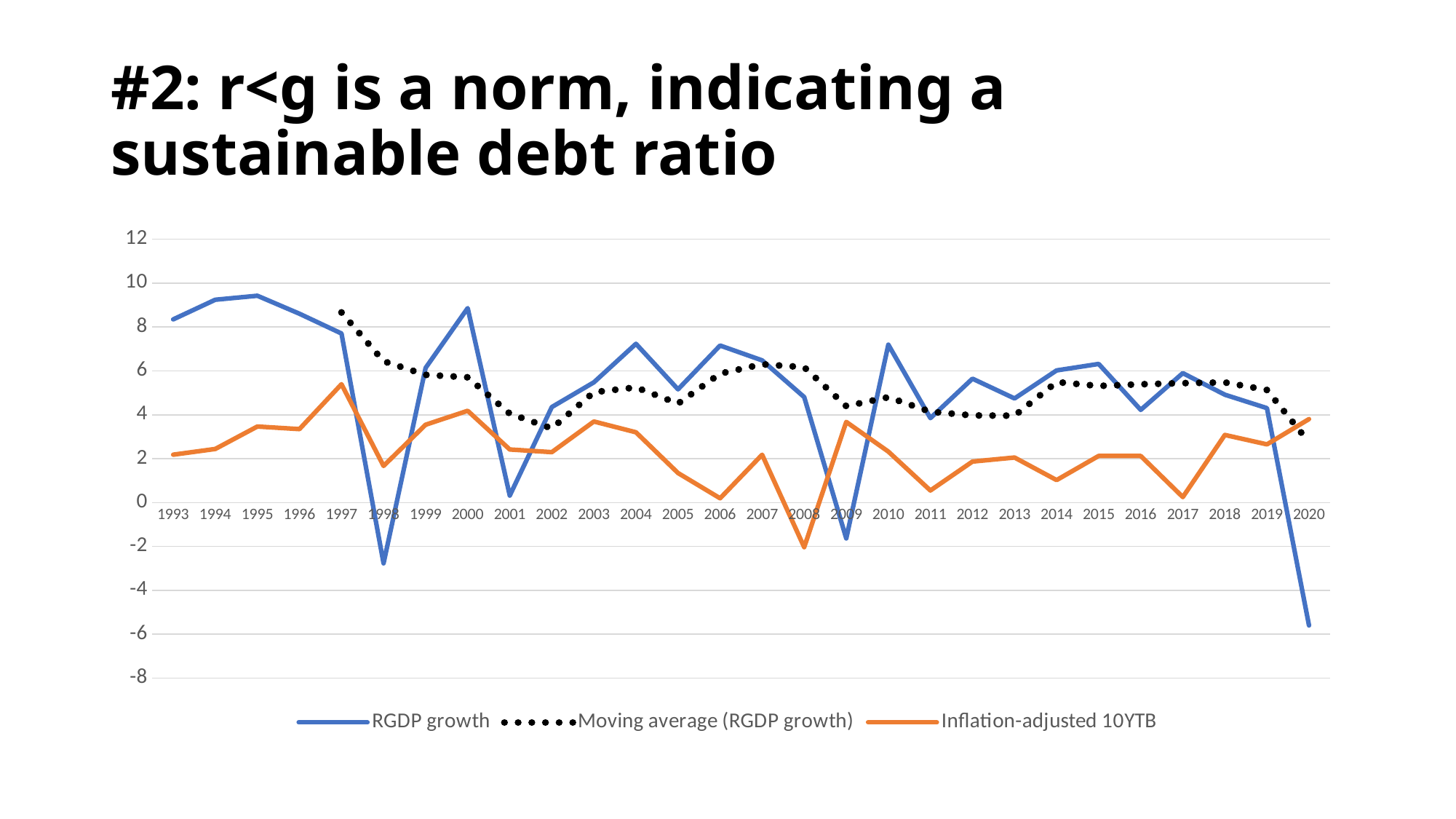
What kind of chart is shown on the slide? line chart In which year is the Inflation-adjusted 10YTB at its lowest? 2008 Does the Inflation-adjusted 10YTB line rise or fall from 2017 to 2020? rise How many series does the legend list? 3 What colour is the Inflation-adjusted 10YTB line? orange Is the value for RGDP growth in 1998 greater or less than 0? less Is the value for the Moving average (RGDP growth) in 1997 greater or less than 8? greater Is the value for RGDP growth in 2000 greater or less than 8? greater In which year is the Inflation-adjusted 10YTB at its highest? 1997 In 2010, which is larger: RGDP growth or Inflation-adjusted 10YTB? RGDP growth In which year is RGDP growth at its lowest? 2020 How many years are plotted along the x axis? 28